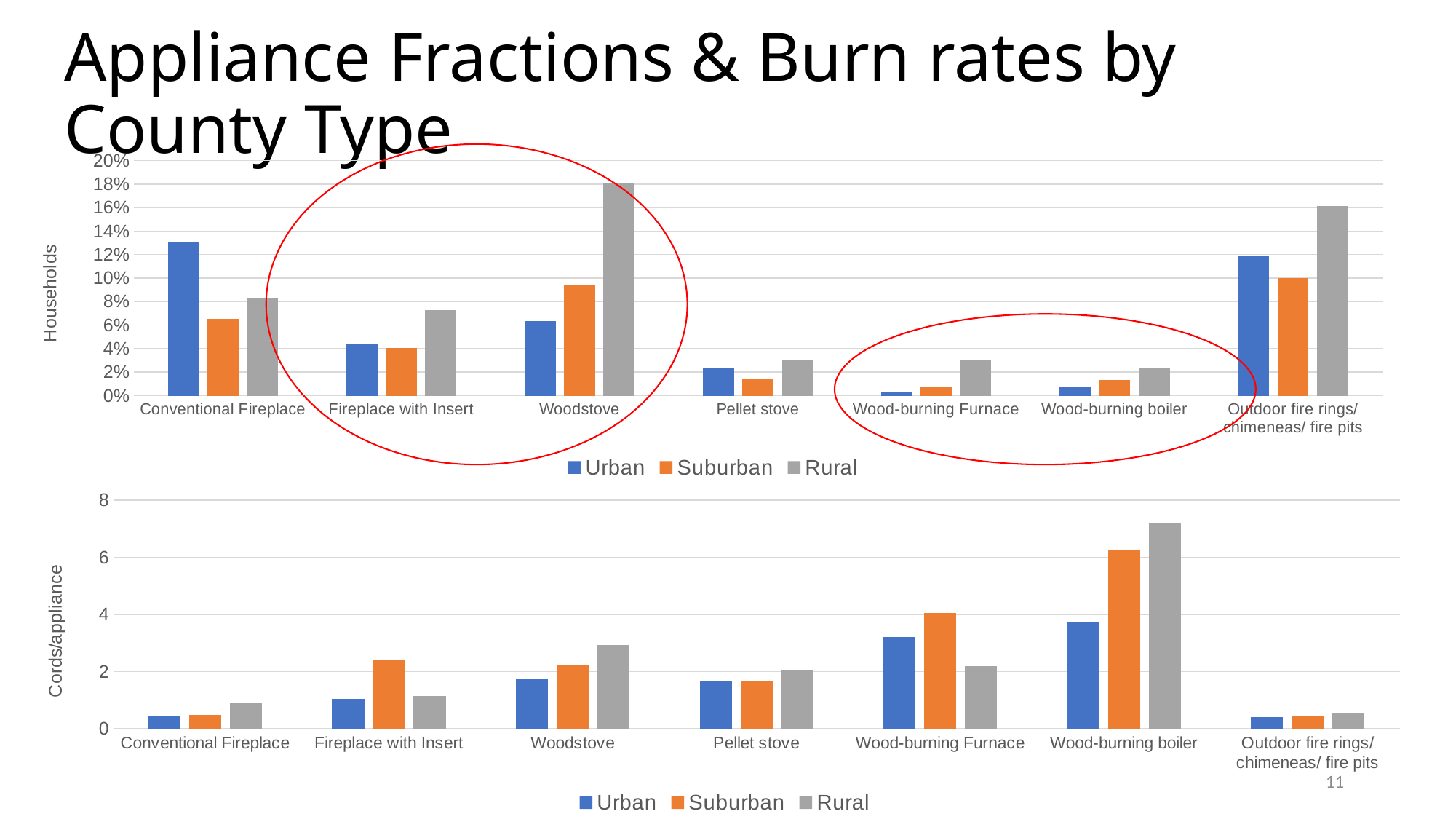
What kind of chart is the bottom chart (Cords/appliance)? bar chart In the top chart (Households), is the Rural value for Woodstove greater or less than 16%? greater In the bottom chart (Cords/appliance), is the Suburban value for Wood-burning boiler greater or less than 6? greater In the top chart (Households), is the Urban value for Conventional Fireplace greater or less than 10%? greater In the top chart (Households), which series has the lowest value for Wood-burning Furnace? Urban How many series does the legend of the bottom chart (Cords/appliance) list? 3 How many appliance categories are shown on the x axis of the top chart (Households)? 7 In the bottom chart (Cords/appliance), which appliance category has the highest Rural value? Wood-burning boiler In the bottom chart (Cords/appliance), which is larger for Wood-burning Furnace: the Suburban value or the Rural value? Suburban In the top chart (Households), which is larger for Conventional Fireplace: the Urban value or the Suburban value? Urban What is the y-axis label of the top chart? Households In the top chart (Households), which series has the highest value for Woodstove? Rural